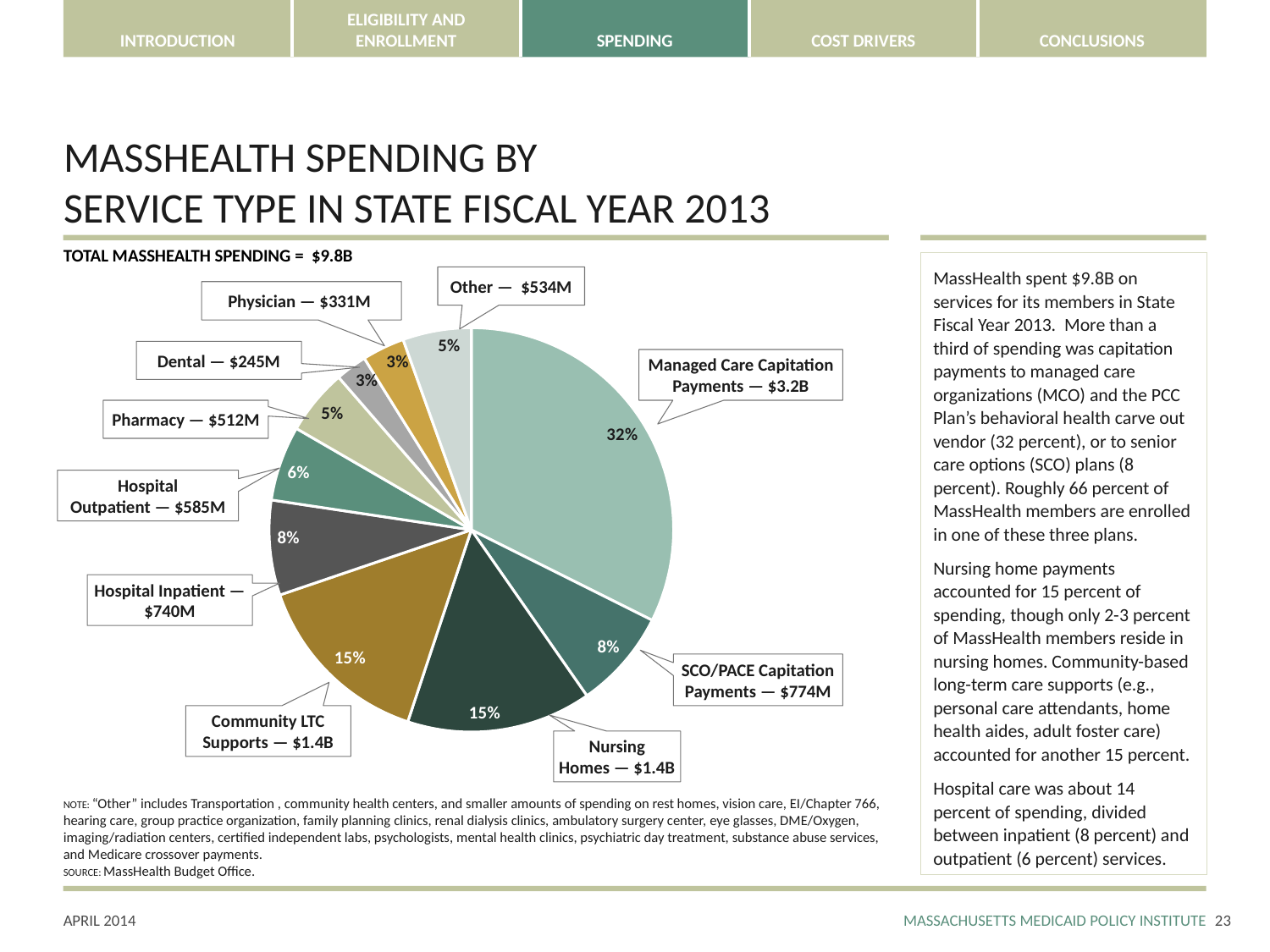
What is the spending amount for Dental? $245M What is the total MassHealth spending shown above the chart? $9.8B What is the difference in spending between Hospital Outpatient ($585M) and Pharmacy ($512M)? $73M What percentage of spending is for SCO/PACE Capitation Payments? 8% What share of MassHealth spending goes to Managed Care Capitation Payments? 32% What kind of chart is shown on the slide? Pie chart Which is larger, spending on Pharmacy or spending on Hospital Outpatient? Hospital Outpatient What is the spending amount for Managed Care Capitation Payments? $3.2B What is the spending amount for Hospital Inpatient? $740M Which service type has the largest share of spending? Managed Care Capitation Payments How many service type slices does the pie chart have? 10 What percentage of spending is for Nursing Homes? 15%